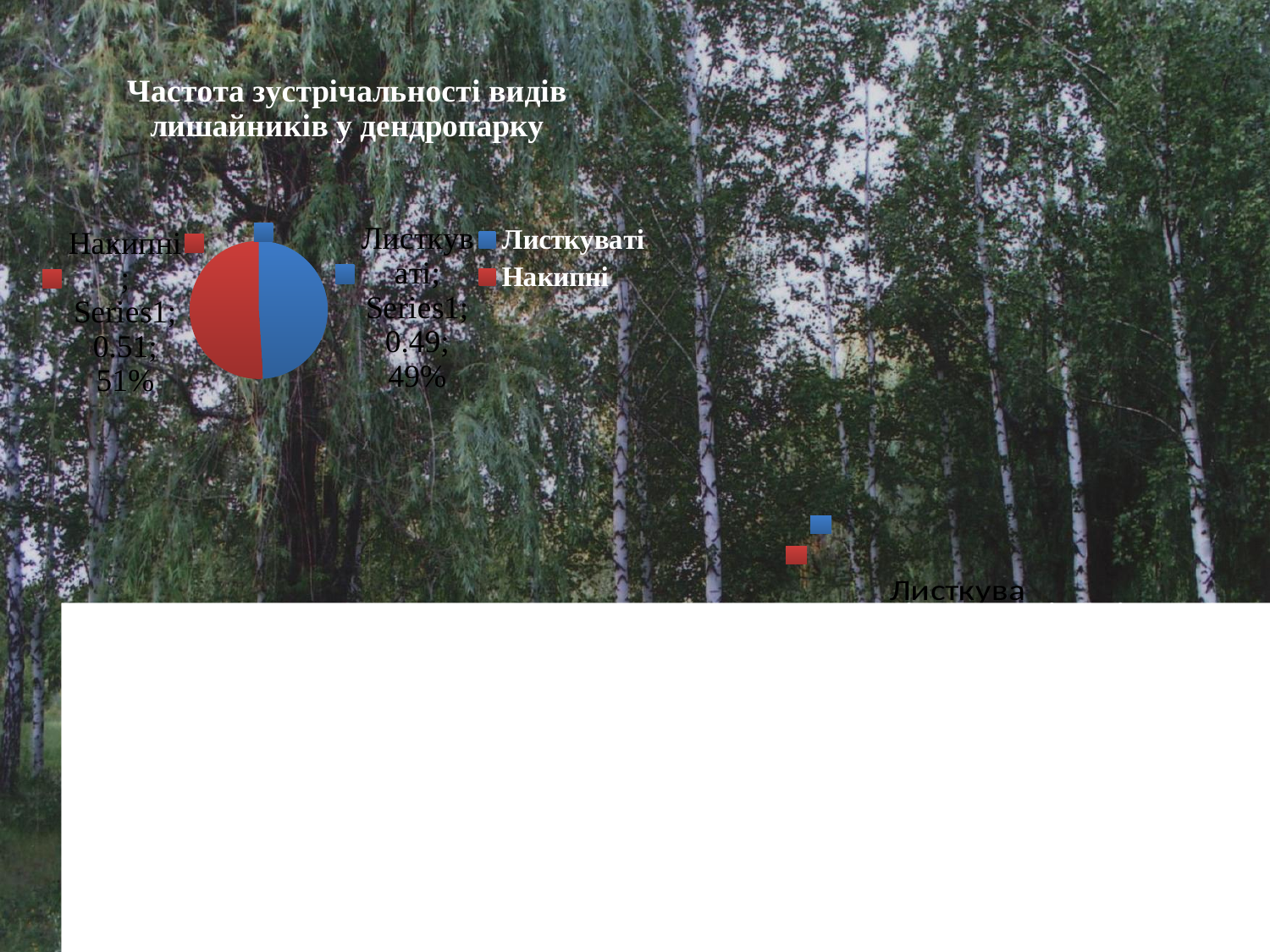
What is the difference in percentage points between the Накипні and Листкуваті shares? 2% What percentage share does the Листкуваті slice have? 49% Which category has the smallest slice of the pie? Листкуваті What percentage share does the Накипні slice have? 51% How many slices does the pie chart have? 2 What value is printed for Листкуваті in the data label? 0.49 Which colour represents Листкуваті in the legend? blue What is the title of the chart? Частота зустрічальності видів лишайників у дендропарку What value is printed for Накипні in the data label? 0.51 Which is larger, the share for Накипні or the share for Листкуваті? Накипні What kind of chart is shown on the slide? pie chart Which category has the largest slice of the pie? Накипні